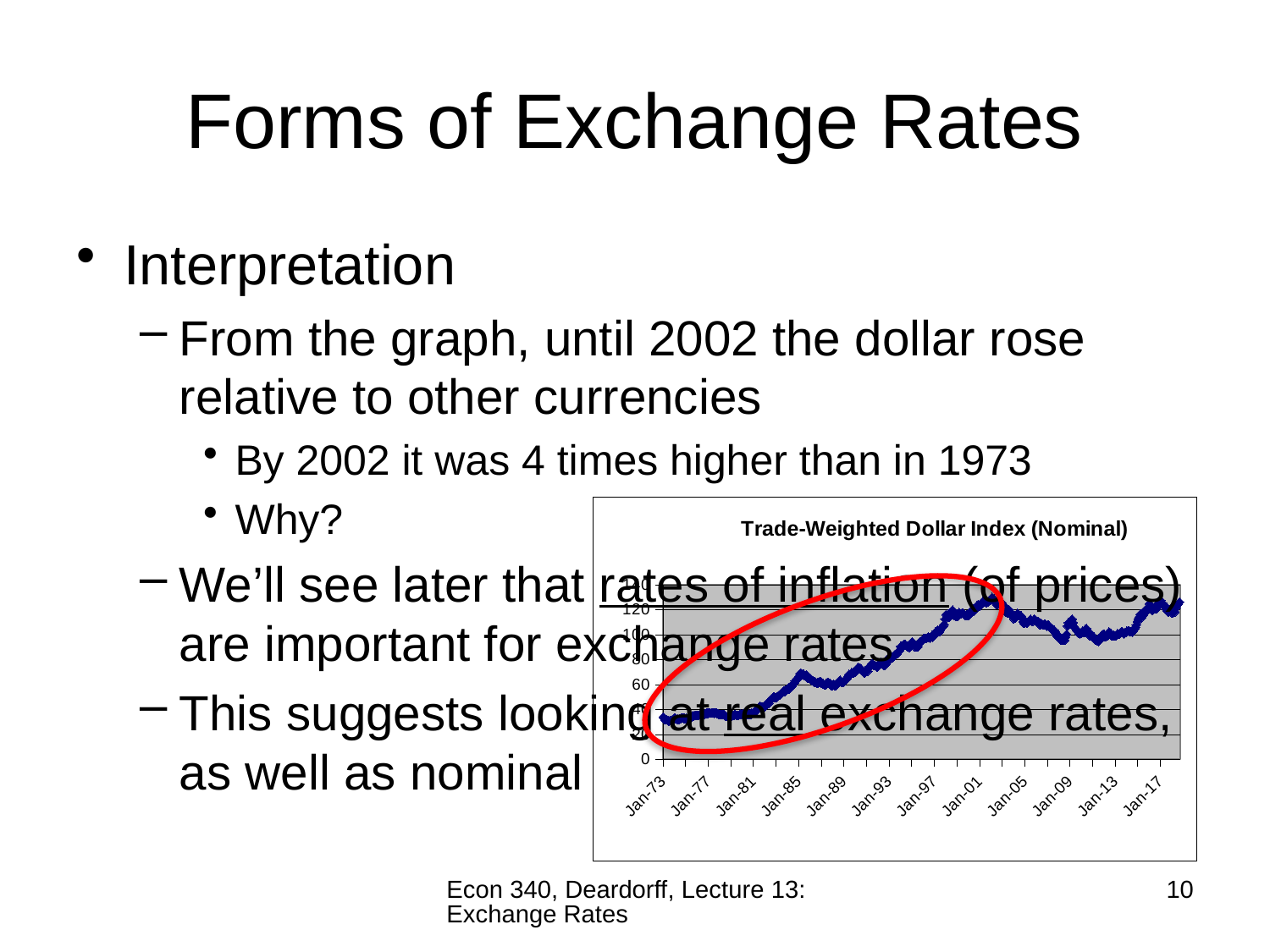
How many series are plotted in the Trade-Weighted Dollar Index chart? 1 Is the value of the Trade-Weighted Dollar Index at Jan-01 greater or less than 100? greater What is the first x-axis label on the Trade-Weighted Dollar Index chart? Jan-73 Is the value of the Trade-Weighted Dollar Index at Jan-17 greater or less than 100? greater Is the value of the Trade-Weighted Dollar Index at Jan-73 greater or less than 60? less In the Trade-Weighted Dollar Index chart, does the index rise or fall between Jan-73 and Jan-01? rise In the Trade-Weighted Dollar Index chart, is the value at Jan-01 larger or smaller than the value at Jan-73? larger What kind of chart is shown on the slide? line chart What is the title of the chart on the slide? Trade-Weighted Dollar Index (Nominal) What is the last x-axis label on the Trade-Weighted Dollar Index chart? Jan-17 How many labelled tick marks are on the x axis of the Trade-Weighted Dollar Index chart? 12